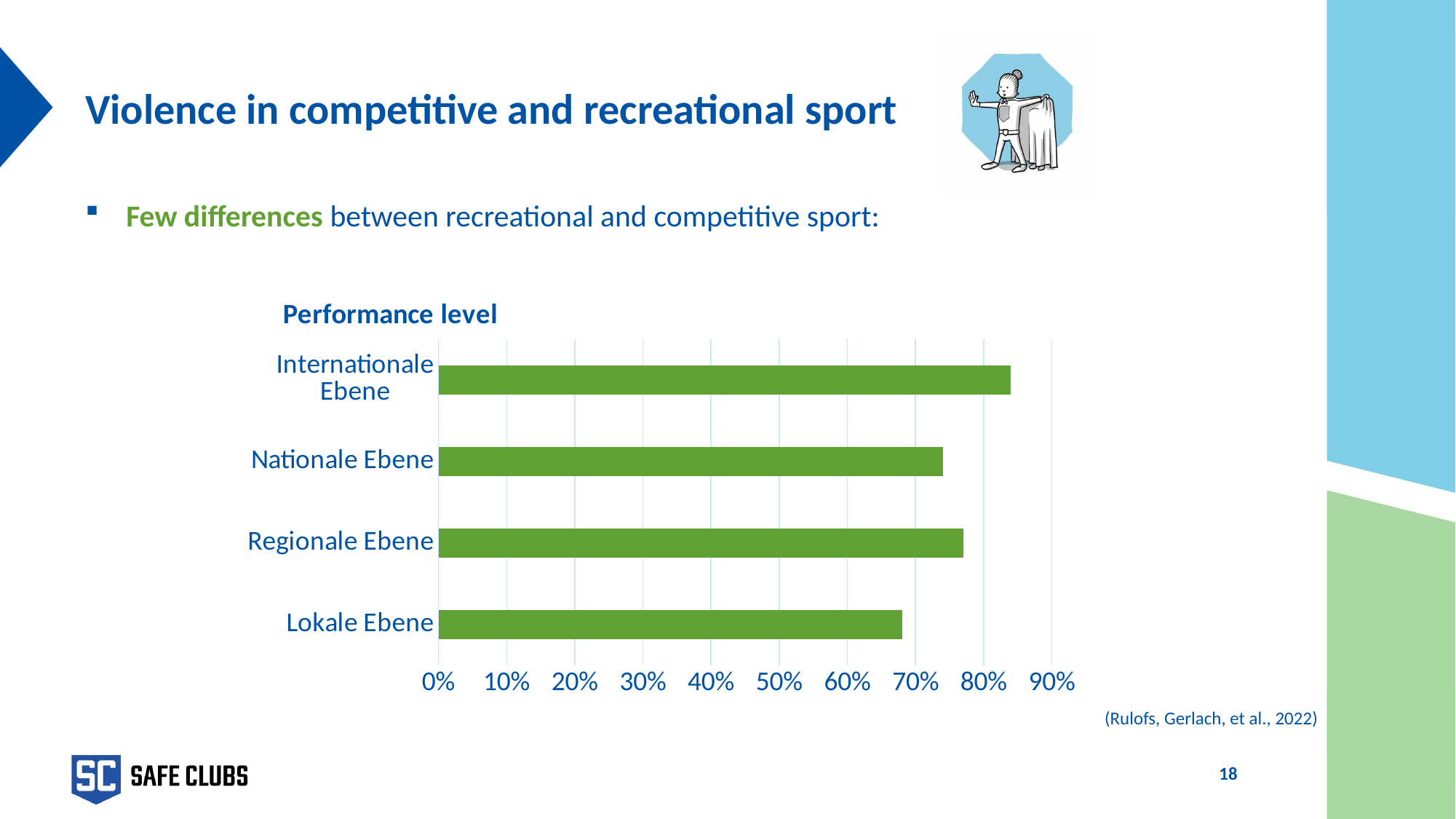
Which performance level has the highest value in the chart? Internationale Ebene What is the title of the chart? Performance level Is the value for Lokale Ebene greater or less than 70%? less Which has the larger value, Regionale Ebene or Lokale Ebene? Regionale Ebene Which performance level has the lowest value in the chart? Lokale Ebene What kind of chart is shown on the slide? bar chart Is the value for Lokale Ebene greater or less than 60%? greater Is the value for Internationale Ebene greater or less than 80%? greater Which has the larger value, Internationale Ebene or Nationale Ebene? Internationale Ebene How many performance levels are plotted in the chart? 4